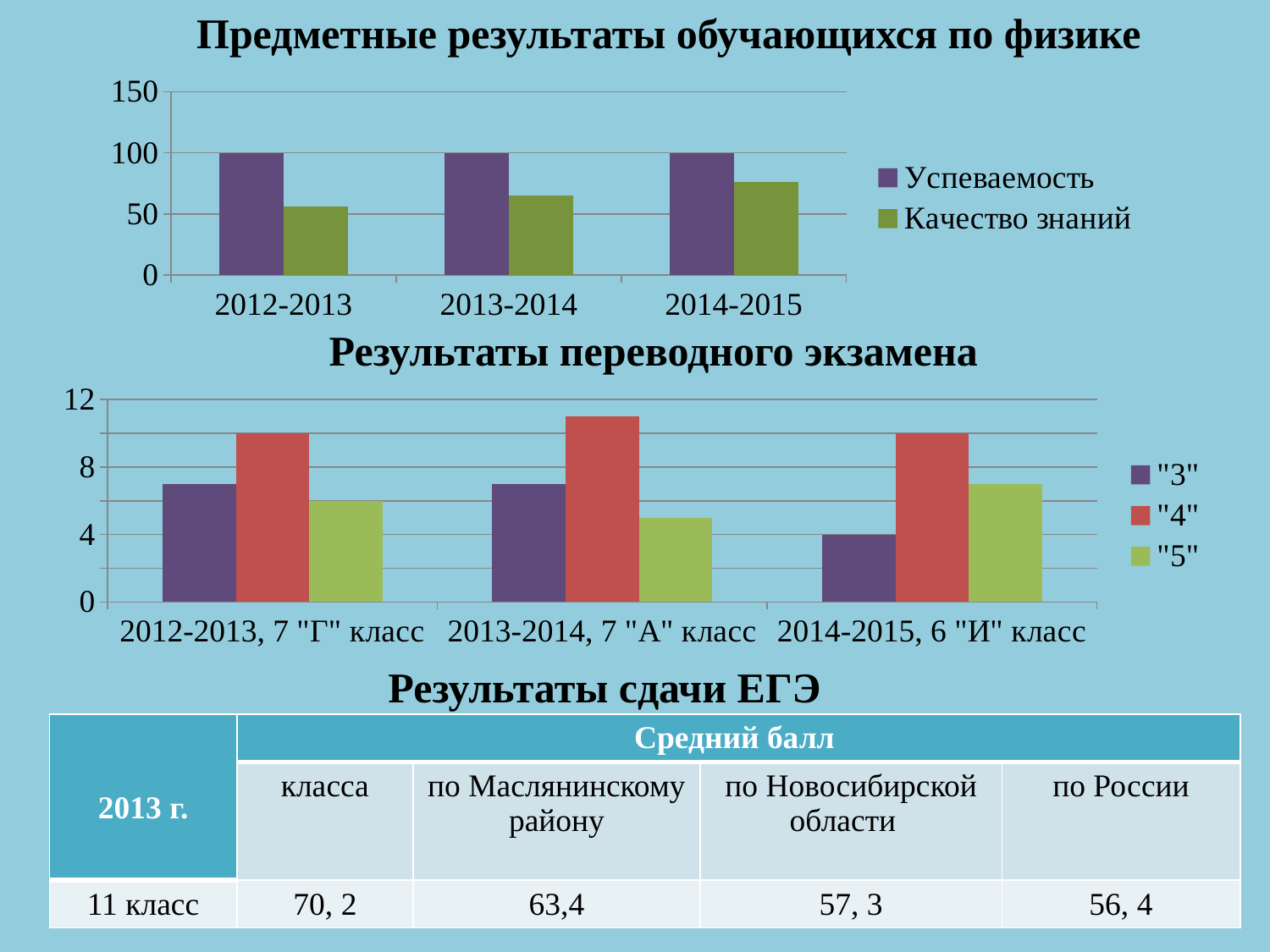
In the chart 'Предметные результаты обучающихся по физике', which series is shown in green? Качество знаний In the chart 'Предметные результаты обучающихся по физике', what is the value of Успеваемость for 2012-2013? 100 In the chart 'Результаты переводного экзамена', which series has the highest value for 2013-2014, 7 "А" класс? "4" What kind of chart is 'Результаты переводного экзамена'? bar chart In the chart 'Результаты переводного экзамена', which series has the lowest value for 2014-2015, 6 "И" класс? "3" In the chart 'Предметные результаты обучающихся по физике', is the value of Качество знаний for 2014-2015 greater or less than 50? greater In the chart 'Результаты переводного экзамена', how many series does the legend list? 3 In the chart 'Предметные результаты обучающихся по физике', how many series does the legend list? 2 In the chart 'Результаты переводного экзамена', is the value of "4" for 2013-2014, 7 "А" класс greater or less than 8? greater In the chart 'Предметные результаты обучающихся по физике', how many categories are shown on the x axis? 3 In the chart 'Результаты переводного экзамена', what is the value of "3" for 2014-2015, 6 "И" класс? 4 In the chart 'Предметные результаты обучающихся по физике', does Качество знаний rise or fall from 2012-2013 to 2014-2015? rise